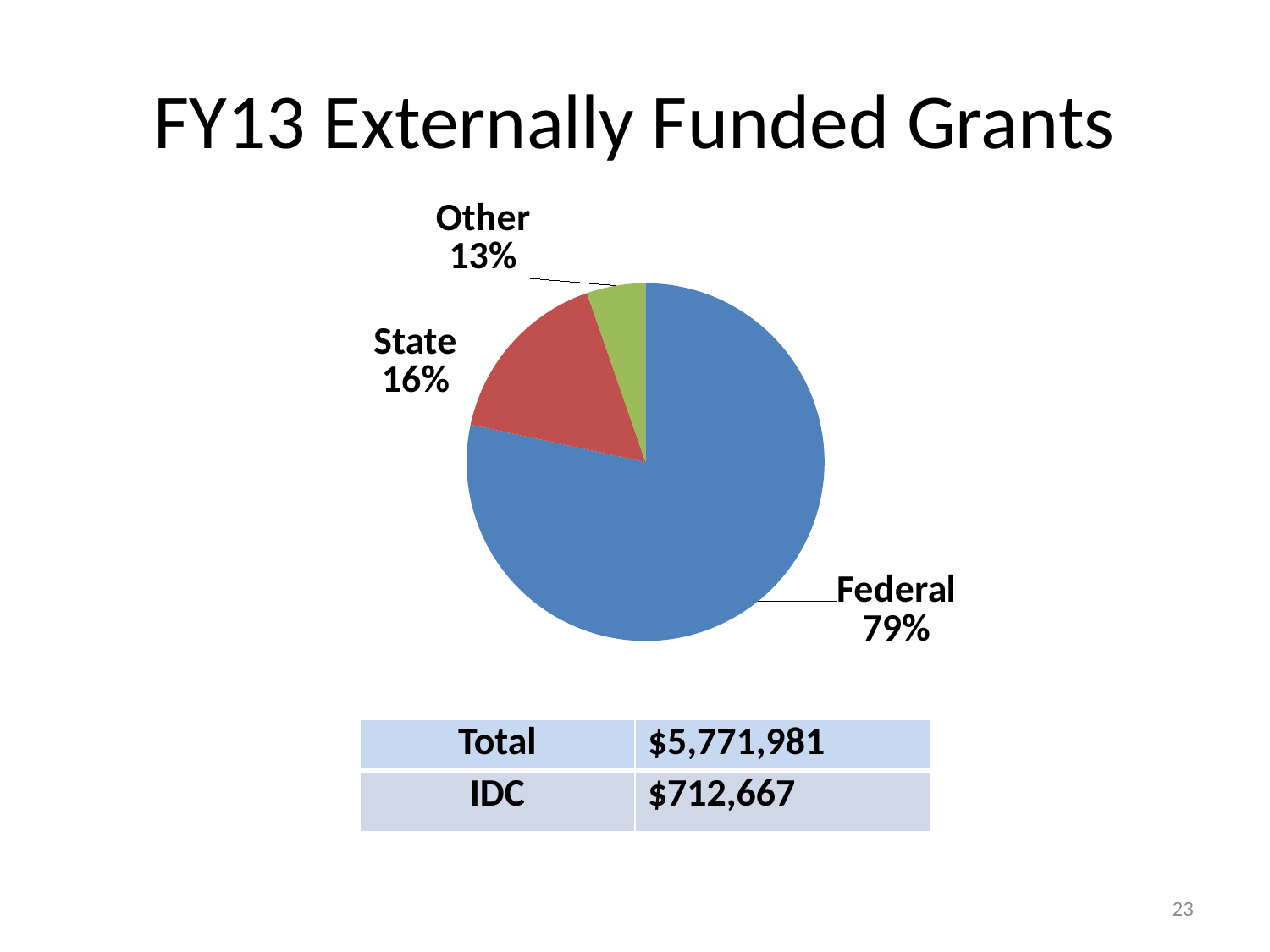
What colour is the Federal slice of the pie? blue What share of the pie does Federal represent? 79% What is the difference in percentage points between the State and Other slices? 3 Which category has the largest slice of the pie? Federal What is the difference in percentage points between the Federal and State slices? 63 How many slices does the pie chart have? 3 Which category has the smallest slice of the pie? Other What share of the pie does State represent? 16% What is the title of the slide containing the pie chart? FY13 Externally Funded Grants What share of the pie does Other represent? 13% Which slice is larger, State or Other? State What kind of chart is shown on the slide? pie chart